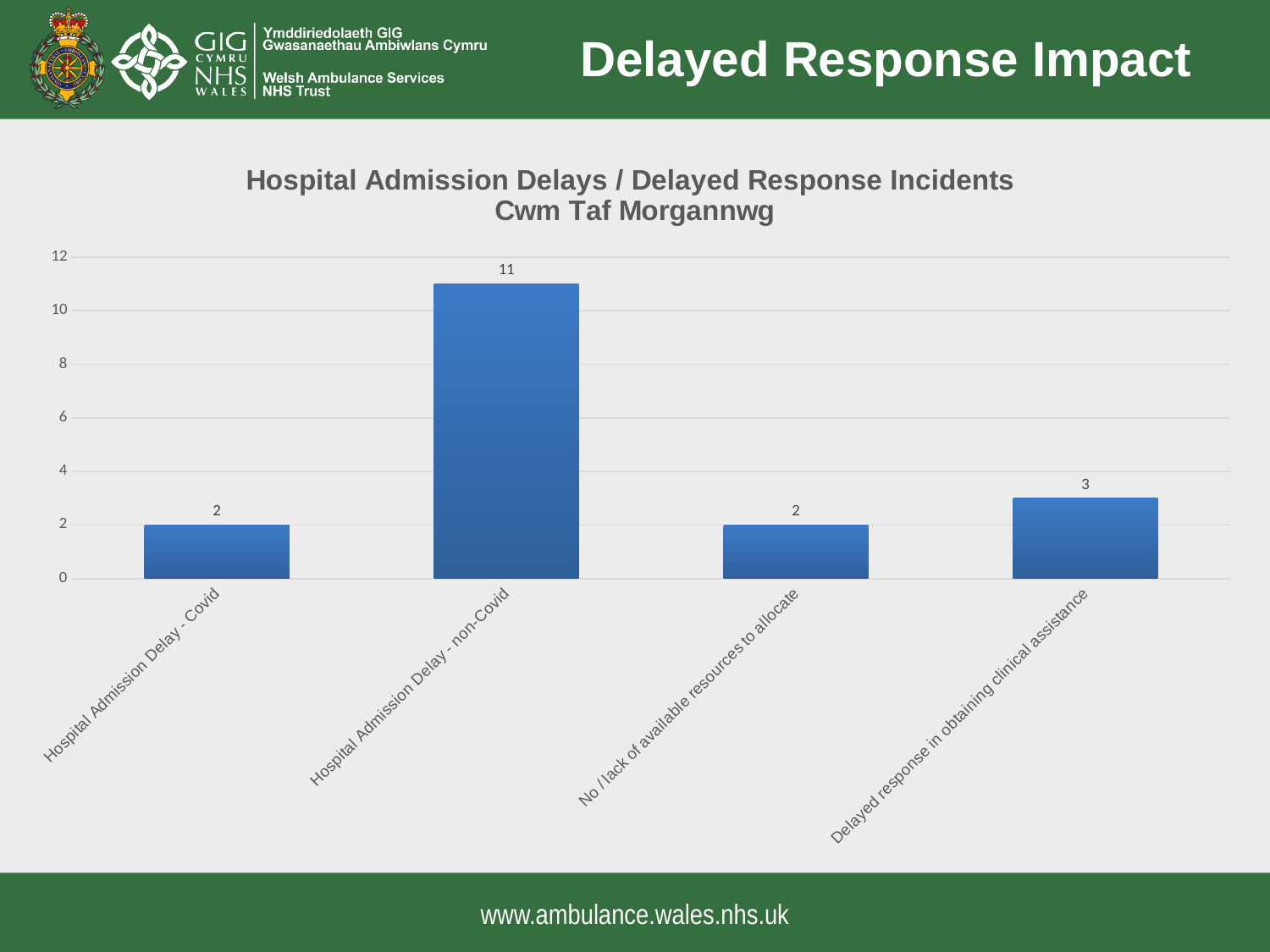
What is the value for Hospital Admission Delay - Covid? 2 What is the value for No / lack of available resources to allocate? 2 What is the title of the chart? Hospital Admission Delays / Delayed Response Incidents Cwm Taf Morgannwg Which is larger: Delayed response in obtaining clinical assistance or Hospital Admission Delay - Covid? Delayed response in obtaining clinical assistance Which category has the highest value? Hospital Admission Delay - non-Covid What is the value for Delayed response in obtaining clinical assistance? 3 What is the difference between Hospital Admission Delay - non-Covid and Delayed response in obtaining clinical assistance? 8 What kind of chart is shown on the slide? bar chart What is the value for Hospital Admission Delay - non-Covid? 11 What is the total of all four bars? 18 Is the value for Hospital Admission Delay - non-Covid greater or less than 10? greater How many categories are shown on the x axis? 4